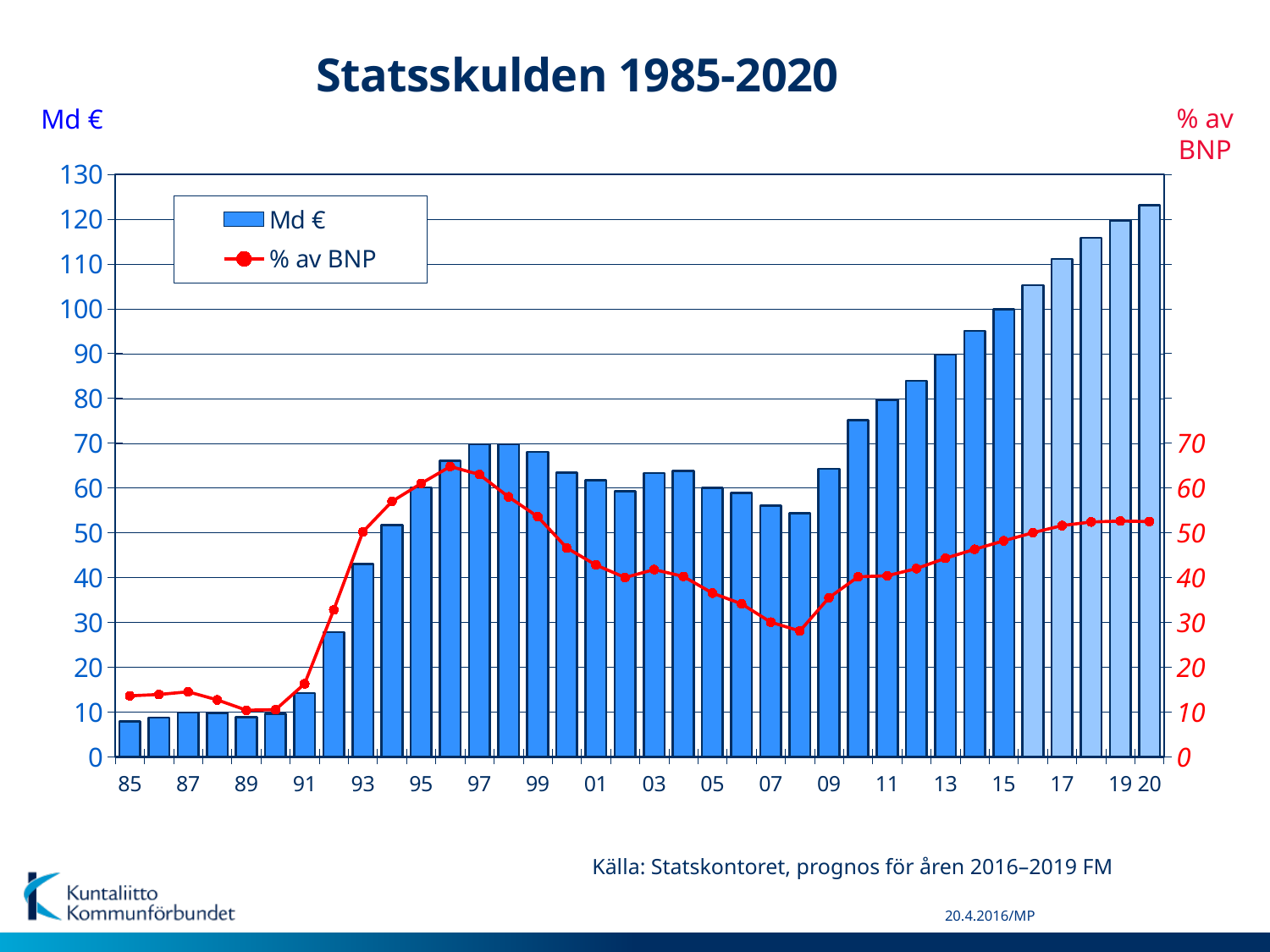
Which year has the highest Md € bar? 20 How many bars (years) are plotted in the chart? 36 Is the Md € value for 15 greater or less than 90? greater Is the % av BNP value for 85 greater or less than 20? less Is the Md € value for 08 greater or less than 60? less How many series does the legend list? 2 Do the Md € bars rise or fall from 09 to 20? rise In which year does the % av BNP line reach its highest point? 96 Which year has the larger Md € bar, 05 or 10? 10 What is the title of the chart? Statsskulden 1985-2020 What kind of chart is shown on the slide? bar chart with a line Which series is plotted as a red line with markers? % av BNP